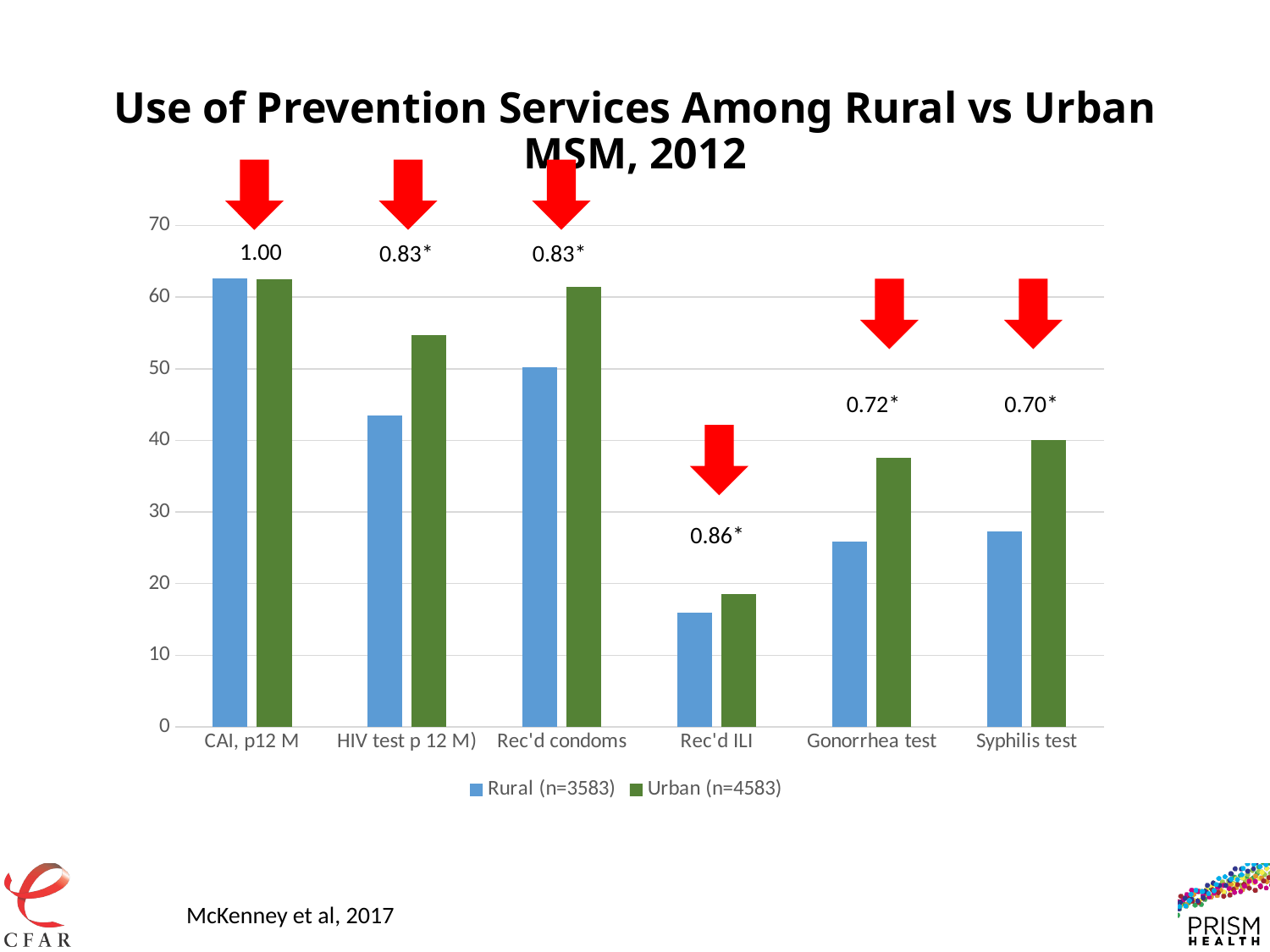
Is the Urban (n=4583) value for Gonorrhea test greater or less than 30? greater Which category has the lowest value for the Urban (n=4583) series? Rec'd ILI What ratio is printed above the CAI, p12 M bars? 1.00 Which category has the highest value for the Rural (n=3583) series? CAI, p12 M Is the Rural (n=3583) value for Rec'd condoms greater or less than 40? greater How many categories are shown along the x axis? 6 Which category has the lowest value for the Rural (n=3583) series? Rec'd ILI For Syphilis test, which series has the larger value, Rural (n=3583) or Urban (n=4583)? Urban (n=4583) What kind of chart is shown on the slide? bar chart Is the Rural (n=3583) value for Rec'd ILI greater or less than 20? less For HIV test p 12 M), which series has the larger value, Rural (n=3583) or Urban (n=4583)? Urban (n=4583) How many series does the legend list? 2